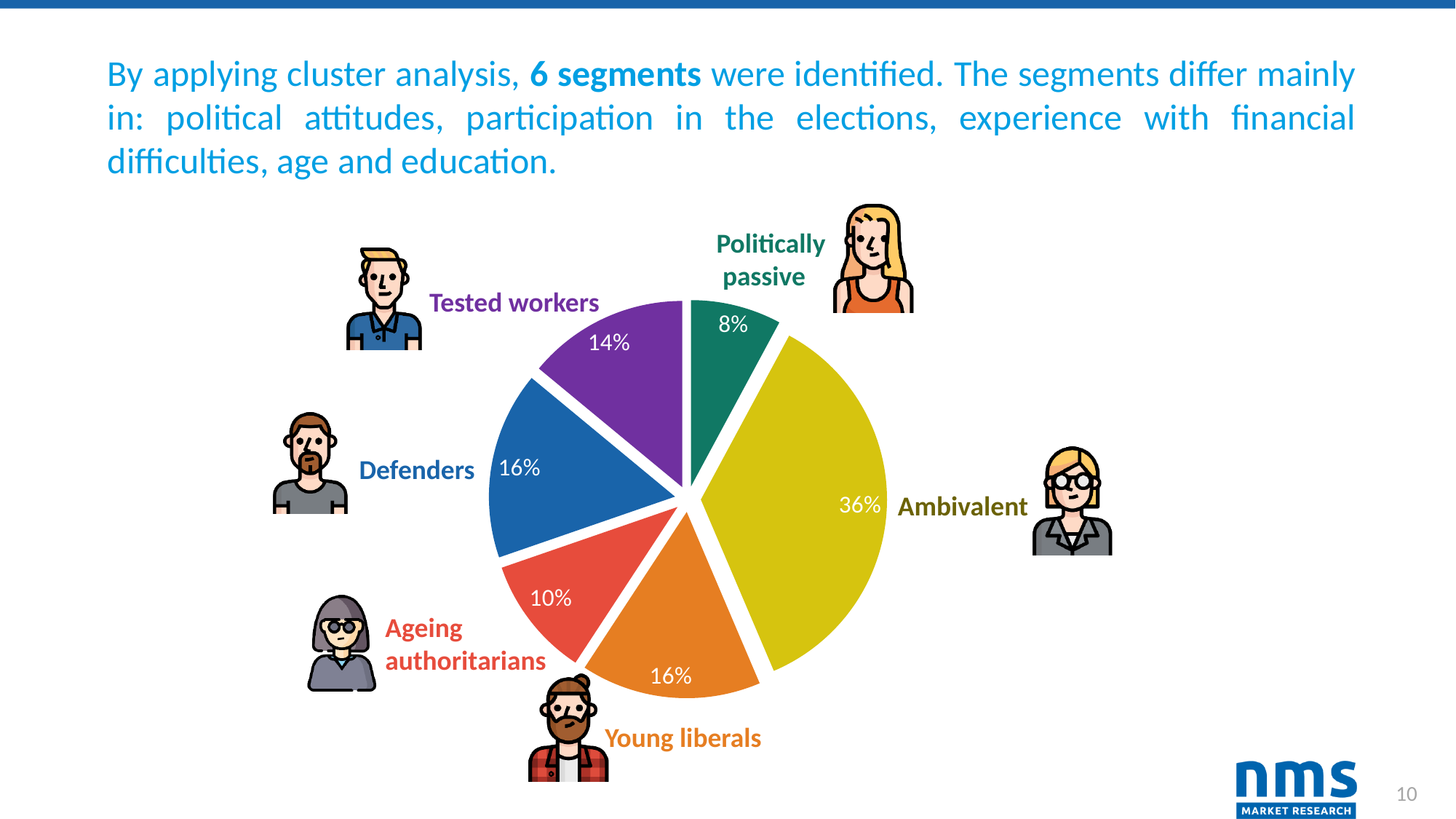
What is the value for Ageing authoritarians? 10% What is the value for the Politically passive segment? 8% What colour is the Ambivalent slice? yellow Which segment has the largest share of the pie? Ambivalent What is the difference between the Ambivalent share and the Defenders share? 20% Which is larger, the share for Tested workers or the share for Ageing authoritarians? Tested workers How many segments are shown in the pie chart? 6 Which segment has the smallest share of the pie? Politically passive What is the value for Tested workers? 14% What is the combined share of Defenders and Young liberals? 32% What share of the pie does the Ambivalent segment have? 36% What kind of chart is shown on the slide? pie chart